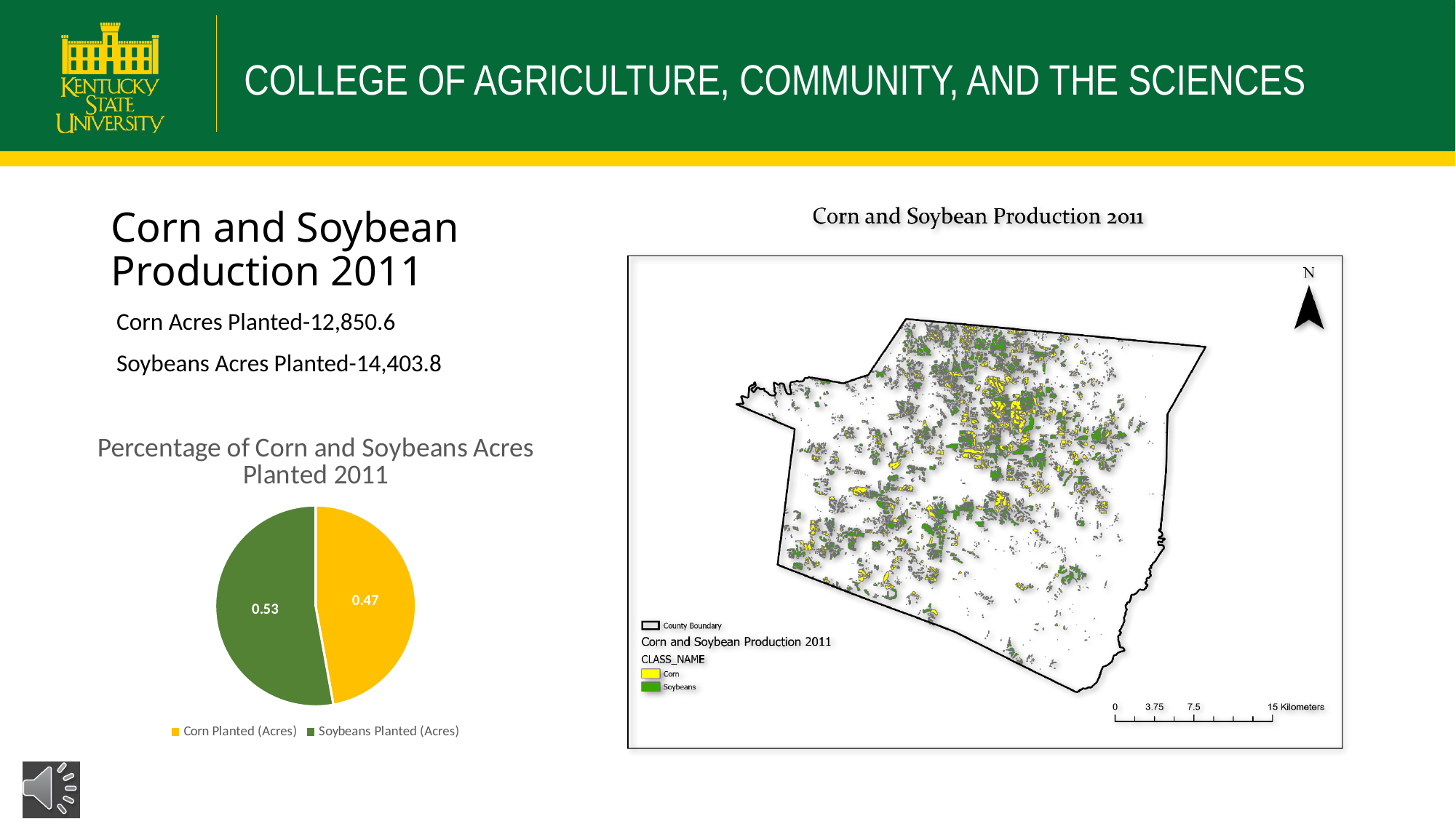
What is the title of the pie chart? Percentage of Corn and Soybeans Acres Planted 2011 How many slices does the pie chart have? 2 Which category has the largest slice in the pie chart? Soybeans Planted (Acres) What kind of chart is shown on the slide? pie chart What value is shown for Soybeans Planted (Acres) in the pie chart? 0.53 What colour is the Corn Planted (Acres) slice in the pie chart? yellow Which category has the smallest slice in the pie chart? Corn Planted (Acres) What is the difference between the Soybeans Planted (Acres) and Corn Planted (Acres) values in the pie chart? 0.06 Which is larger in the pie chart, Corn Planted (Acres) or Soybeans Planted (Acres)? Soybeans Planted (Acres) How many entries does the pie chart legend list? 2 What value is shown for Corn Planted (Acres) in the pie chart? 0.47